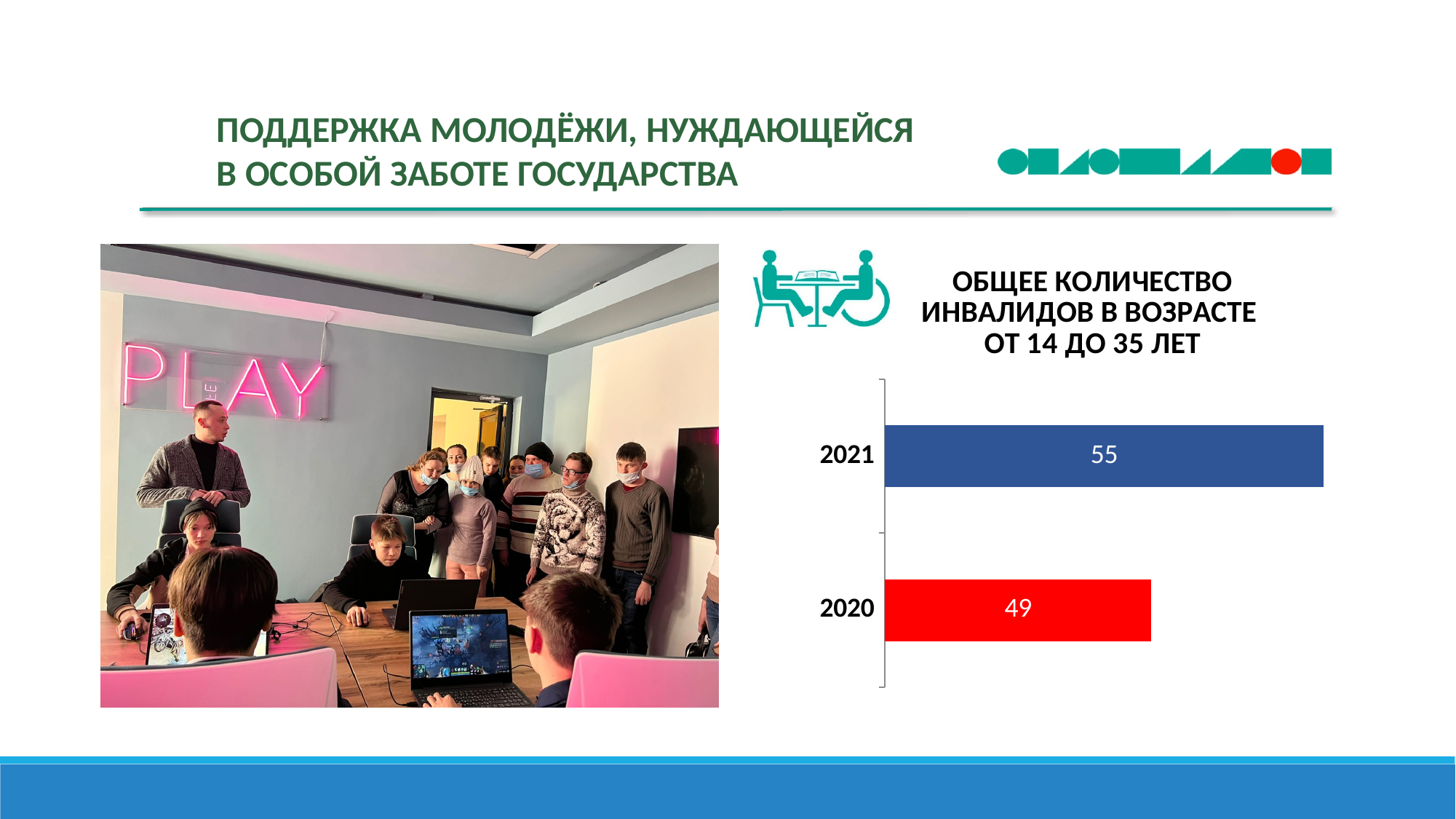
What kind of chart is shown on the slide? bar chart Which is larger, the value for 2020 or the value for 2021? 2021 What is the difference between the values for 2021 and 2020? 6 What is the value for 2020? 49 Did the value rise or fall from 2020 to 2021? rise Which year has the highest value? 2021 Which year has the lowest value? 2020 What is the value for 2021? 55 How many categories are shown in the chart? 2 What colour is the bar for 2020? red What is the title of the chart? ОБЩЕЕ КОЛИЧЕСТВО ИНВАЛИДОВ В ВОЗРАСТЕ ОТ 14 ДО 35 ЛЕТ